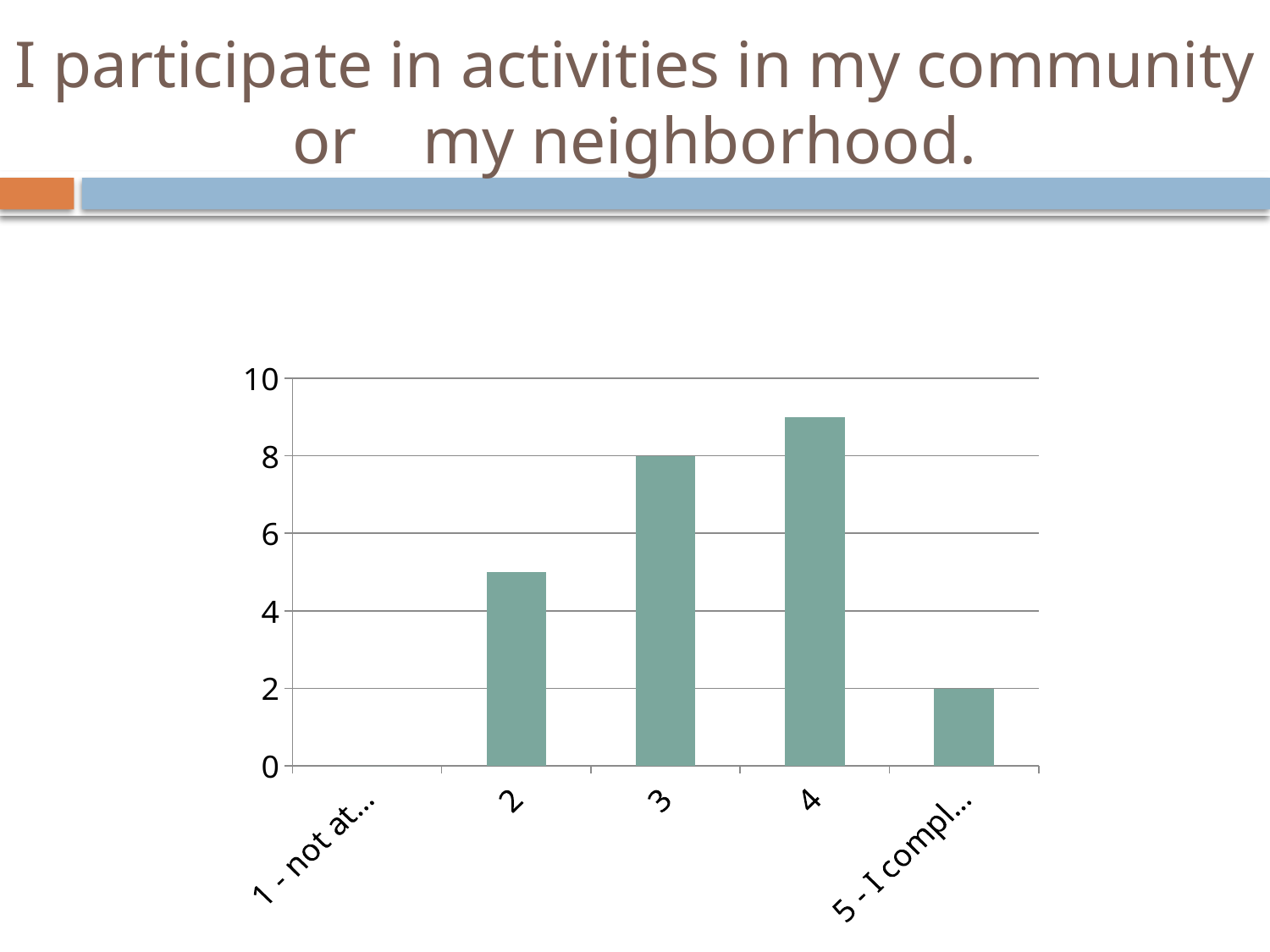
Is the value for category 4 greater or less than 8? greater Which is larger, the value for category 3 or the value for "5 - I compl..."? 3 Which category has the highest bar? 4 Is the value for category 2 greater or less than 4? greater How many categories are shown on the x axis? 5 What type of chart is shown on the slide? bar chart Which category has the lowest value? 1 - not at... What is the value for category 3? 8 Is the value for category 2 greater or less than 6? less What is the value for the category "5 - I compl..."? 2 Do the values rise or fall from category 2 to category 4? rise What is the difference between the value for category 3 and the value for "5 - I compl..."? 6